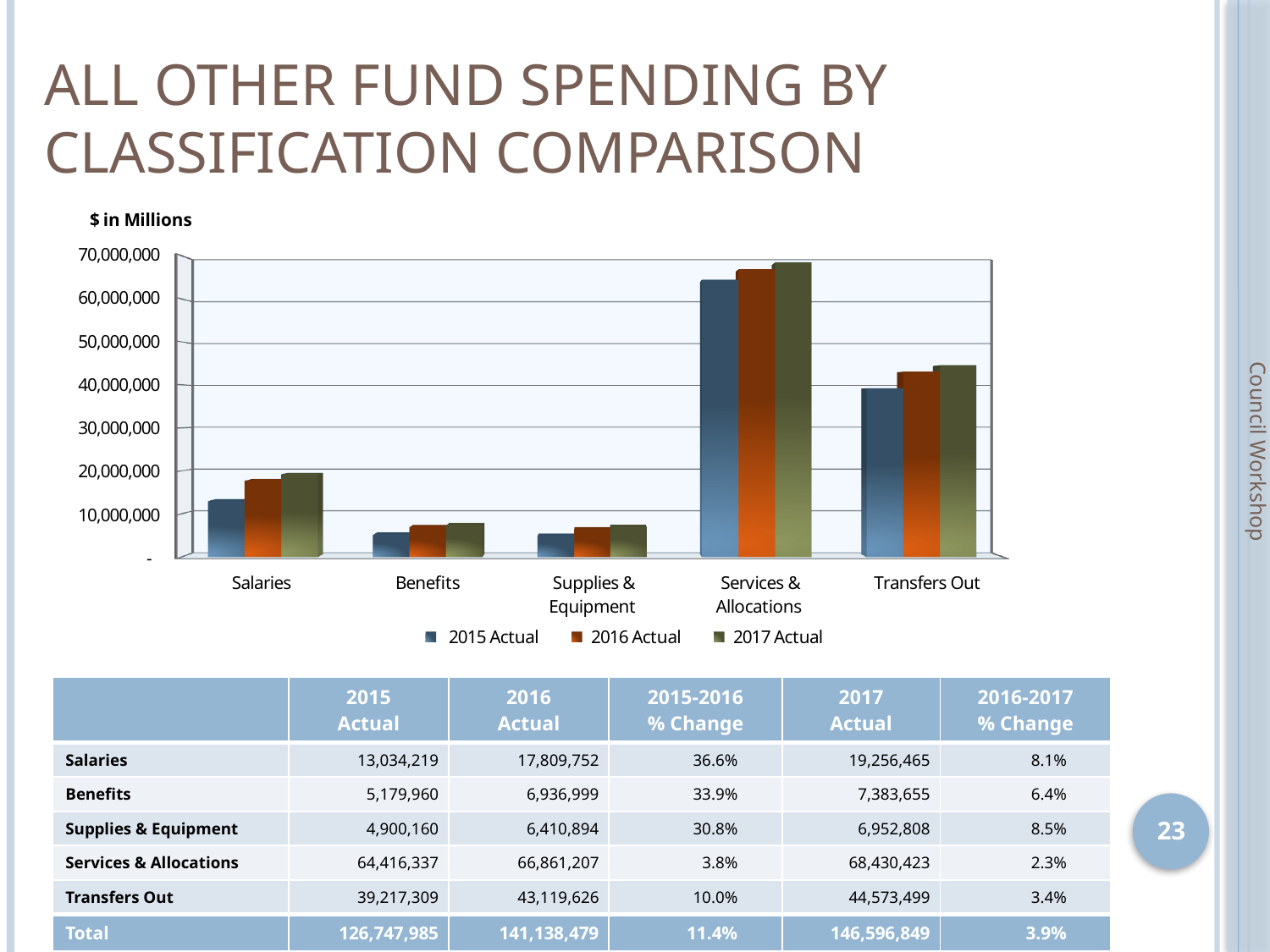
Is the 2017 Actual value for Benefits greater or less than 10,000,000? less How many spending classifications are shown on the x axis of the chart? 5 What is the 2015-2016 % Change for Benefits? 33.9% Which is larger for Transfers Out: the 2015 Actual or the 2017 Actual value? 2017 Actual How many series does the chart legend list? 3 Which classification has the highest spending in 2017 Actual? Services & Allocations Do the Salaries values rise or fall from 2015 Actual to 2017 Actual? rise What is the 2016 Actual value for Transfers Out? 43,119,626 What is the 2017 Actual value for Salaries? 19,256,465 Is the 2015 Actual value for Services & Allocations greater or less than 60,000,000? greater Which classification has the lowest spending in 2015 Actual? Supplies & Equipment What kind of chart is shown on the slide? bar chart